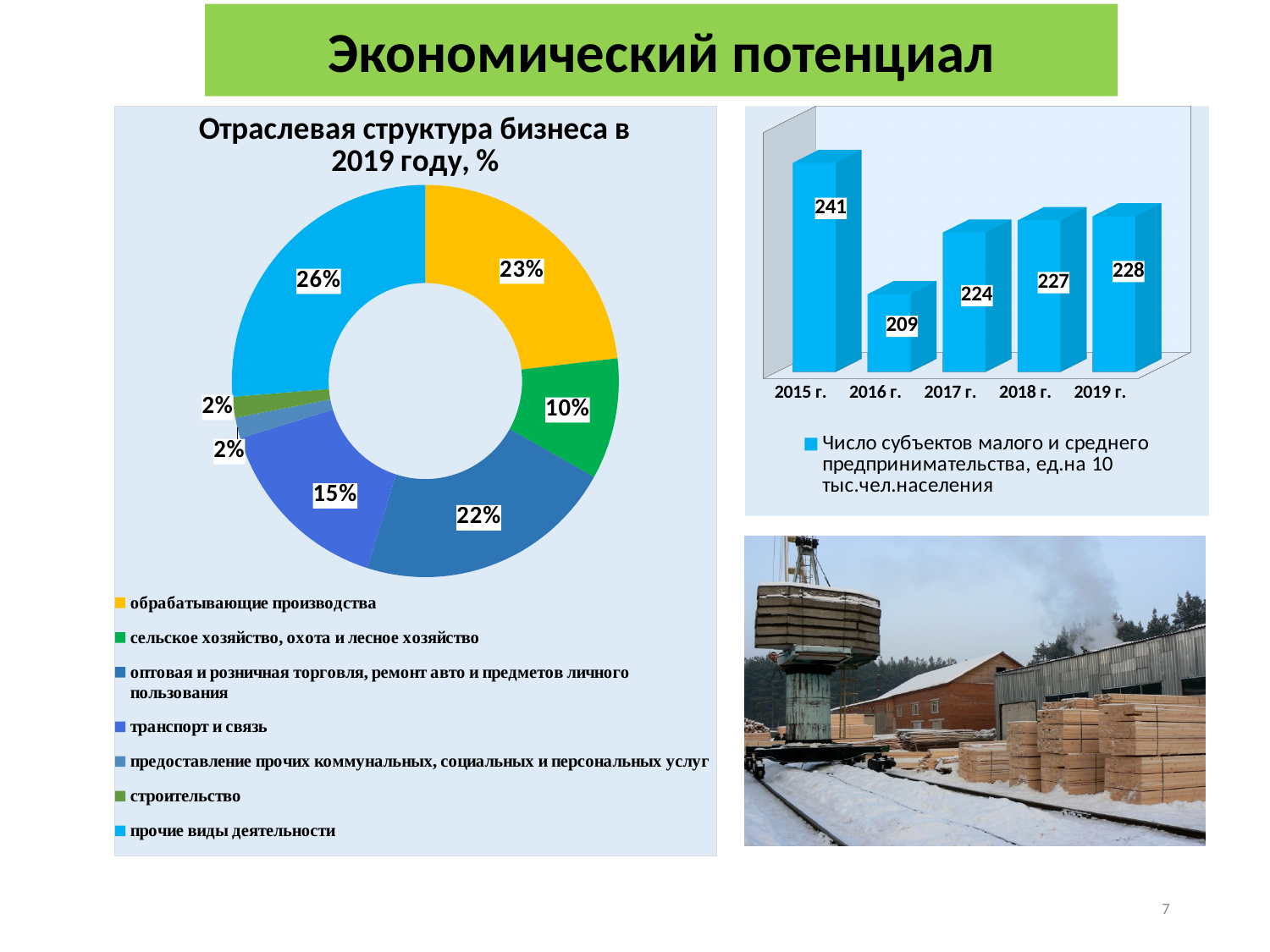
On the bar chart at the top right, how many years are shown on the x axis? 5 On the bar chart at the top right, what is the value for 2015 г.? 241 On the chart 'Отраслевая структура бизнеса в 2019 году, %', how many categories does the legend list? 7 On the chart 'Отраслевая структура бизнеса в 2019 году, %', what share does 'обрабатывающие производства' have? 23% On the chart 'Отраслевая структура бизнеса в 2019 году, %', which category has the largest share? прочие виды деятельности On the bar chart at the top right, what is the difference between the values for 2015 г. and 2016 г.? 32 On the bar chart at the top right, is the value for 2018 г. or 2019 г. larger? 2019 г. On the chart 'Отраслевая структура бизнеса в 2019 году, %', what is the difference between the shares of 'оптовая и розничная торговля, ремонт авто и предметов личного пользования' and 'транспорт и связь'? 7% What kind of chart is the one titled 'Отраслевая структура бизнеса в 2019 году, %'? doughnut chart On the chart 'Отраслевая структура бизнеса в 2019 году, %', what is the share of 'сельское хозяйство, охота и лесное хозяйство'? 10% On the bar chart at the top right, which year has the lowest value? 2016 г. On the chart 'Отраслевая структура бизнеса в 2019 году, %', what share does 'транспорт и связь' have? 15%